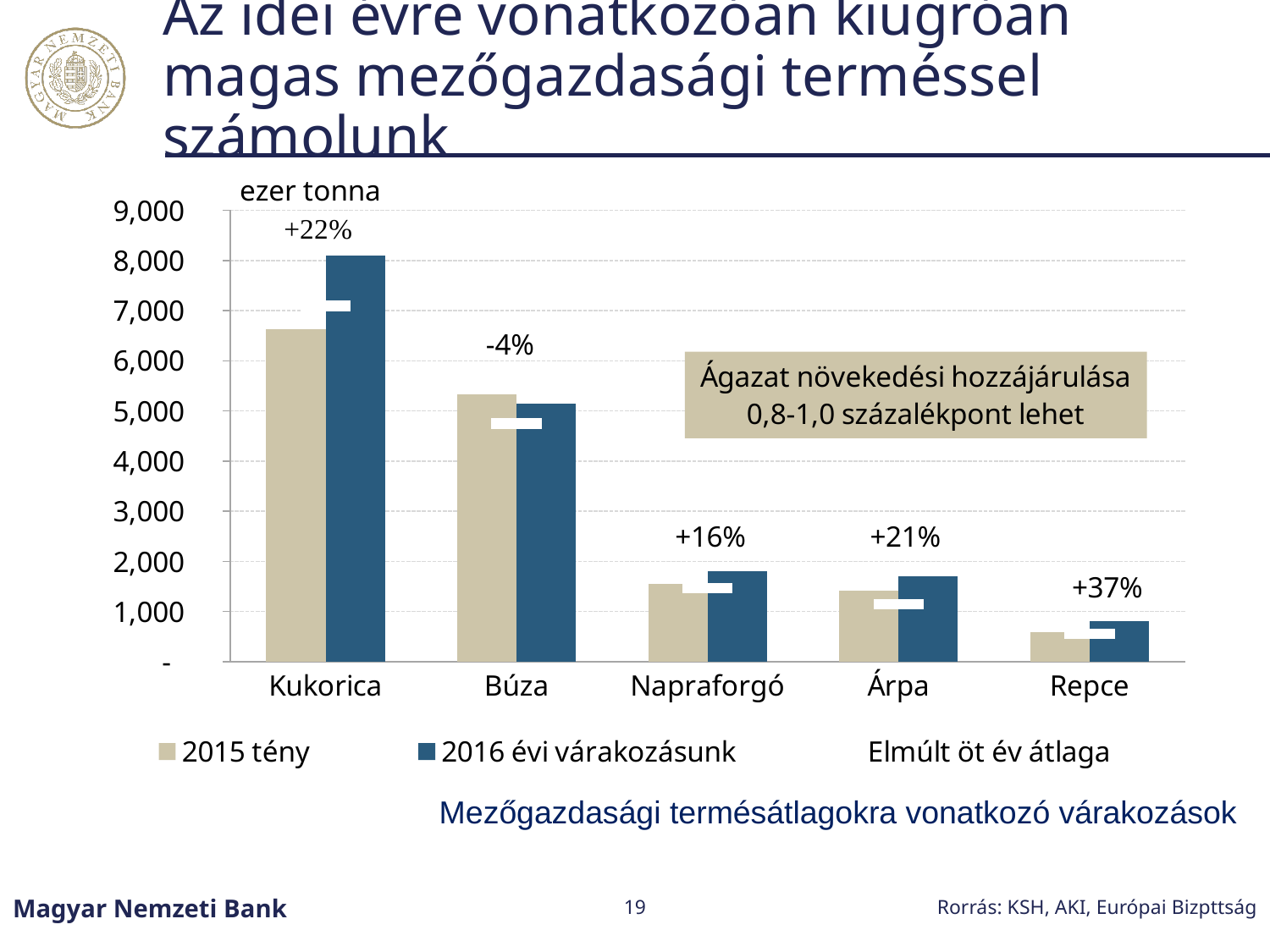
What percentage change is labelled above the Kukorica bars? +22% What percentage change is labelled above the Búza bars? -4% Is the 2016 évi várakozásunk value for Kukorica greater or less than 7,000? greater Is the 2016 évi várakozásunk value for Napraforgó greater or less than 2,000? less What unit is shown at the top of the chart's vertical axis? ezer tonna Which crop has the lowest 2015 tény value? Repce What kind of chart is shown on the slide? bar chart How many crop categories are shown on the x axis? 5 For Búza, which is larger: the 2015 tény value or the 2016 évi várakozásunk value? 2015 tény What percentage change is labelled above the Repce bars? +37% Which crop has the highest 2016 évi várakozásunk value? Kukorica How many series does the legend list? 3